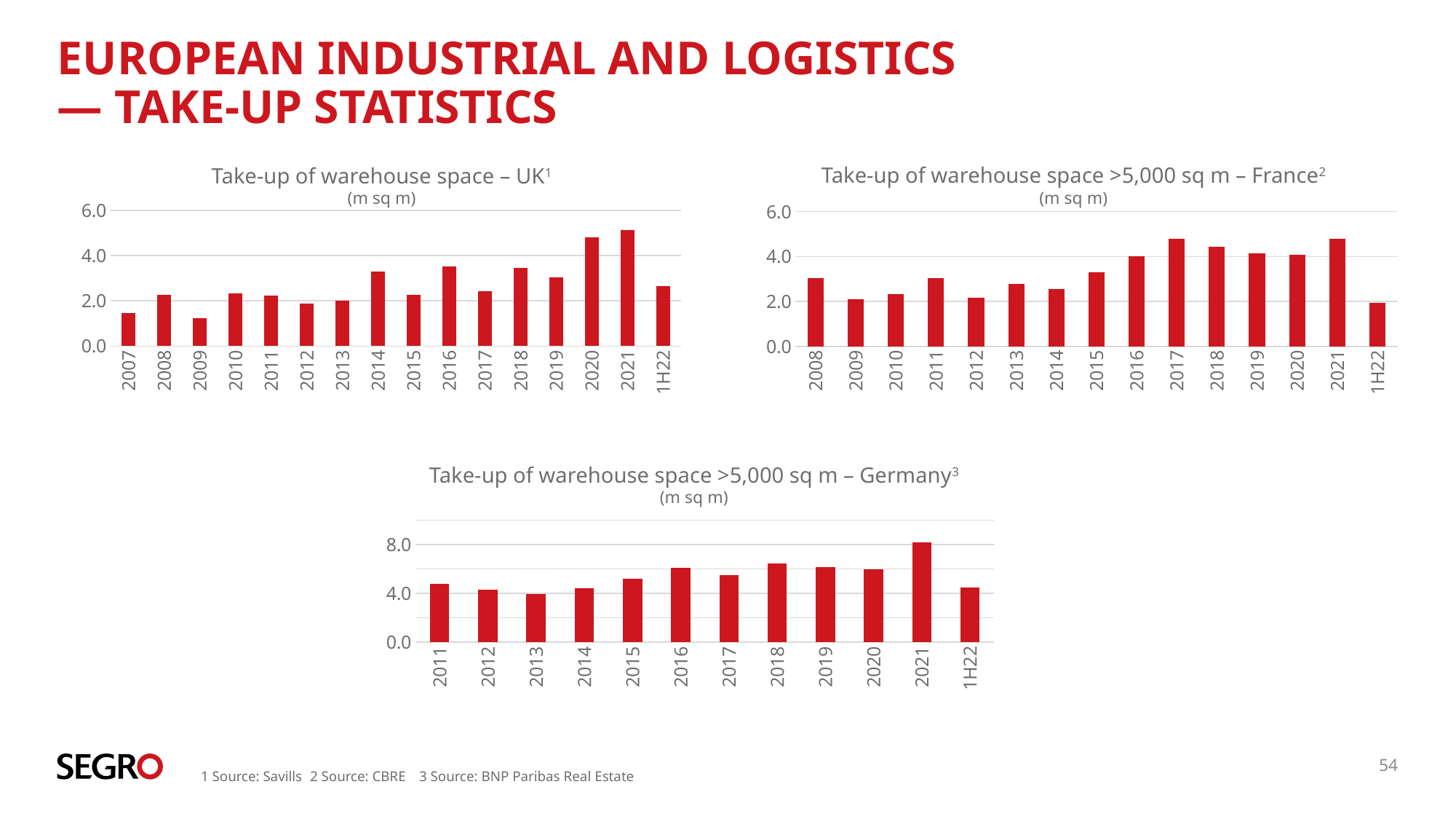
In the 'Take-up of warehouse space >5,000 sq m – Germany' chart, which is larger, the value for 2021 or the value for 2013? 2021 In the 'Take-up of warehouse space – UK' chart, which year has the highest take-up? 2021 In the 'Take-up of warehouse space – UK' chart, which year has the lowest take-up? 2009 How many bars are plotted in the 'Take-up of warehouse space – UK' chart? 16 In the 'Take-up of warehouse space – UK' chart, is the value for 2021 greater or less than 4.0? greater In the 'Take-up of warehouse space >5,000 sq m – Germany' chart, which year has the highest take-up? 2021 In the 'Take-up of warehouse space >5,000 sq m – France' chart, is the value for 2012 greater or less than 4.0? less In the 'Take-up of warehouse space – UK' chart, is the value for 2009 greater or less than 2.0? less How many bars are plotted in the 'Take-up of warehouse space >5,000 sq m – France' chart? 15 What unit is shown under the title of the 'Take-up of warehouse space – UK' chart? m sq m What kind of chart is the 'Take-up of warehouse space >5,000 sq m – Germany' chart? bar chart